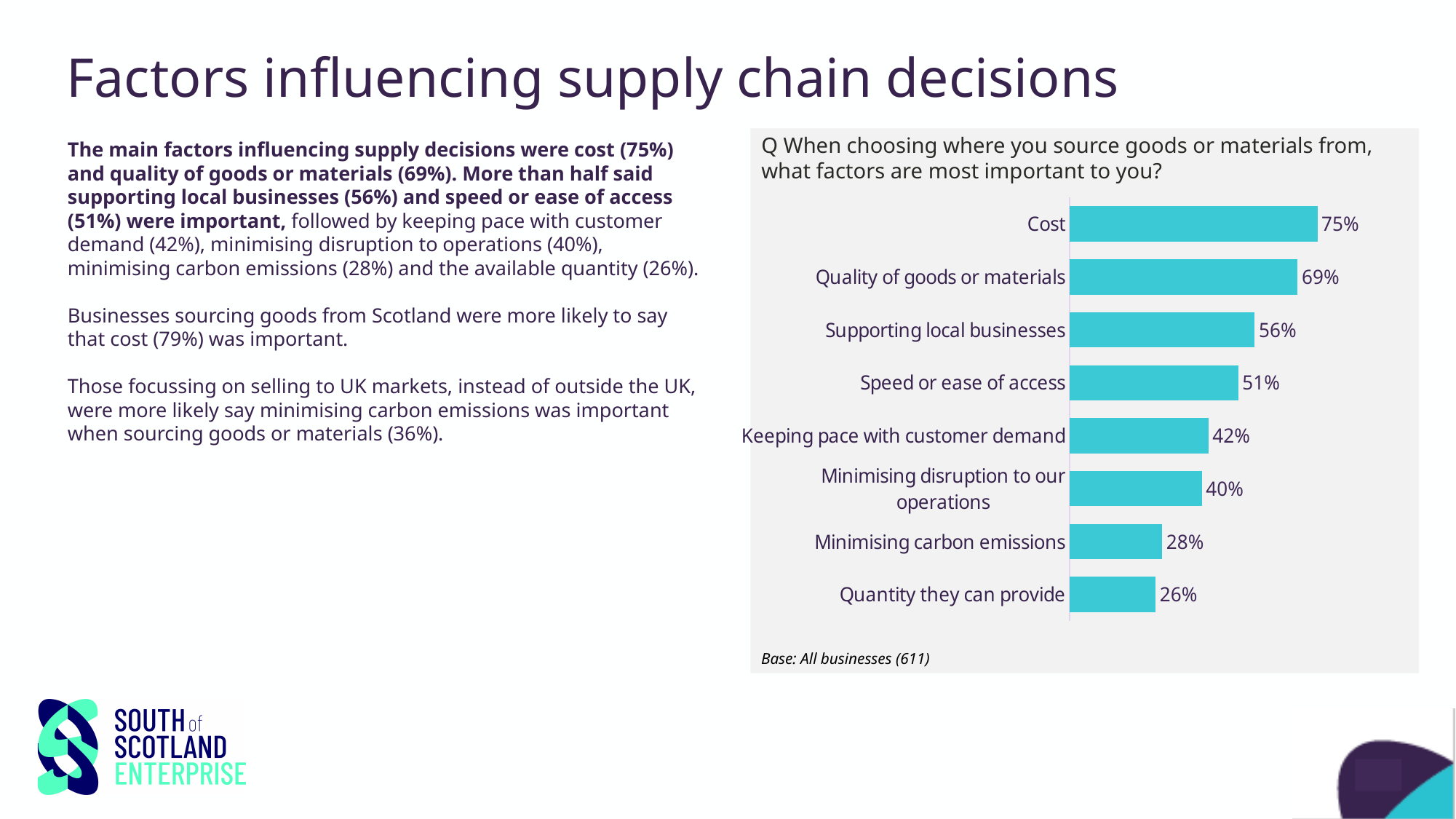
How many factors (categories) are shown in the chart? 8 What is the difference in percentage points between Cost and Quality of goods or materials? 6 What is the value shown for Supporting local businesses? 56% Which factor has the highest percentage in the chart? Cost What type of chart is shown on the slide? Bar chart What percentage is shown for Minimising carbon emissions? 28% What percentage of businesses said Cost was an important factor? 75% What is the base (number of businesses) stated beneath the chart? All businesses (611) What is the difference in percentage points between Speed or ease of access and Keeping pace with customer demand? 9 Which factor has the lowest percentage in the chart? Quantity they can provide Do the values rise or fall going from the top bar to the bottom bar? Fall Which is larger: the value for Minimising disruption to our operations or the value for Minimising carbon emissions? Minimising disruption to our operations